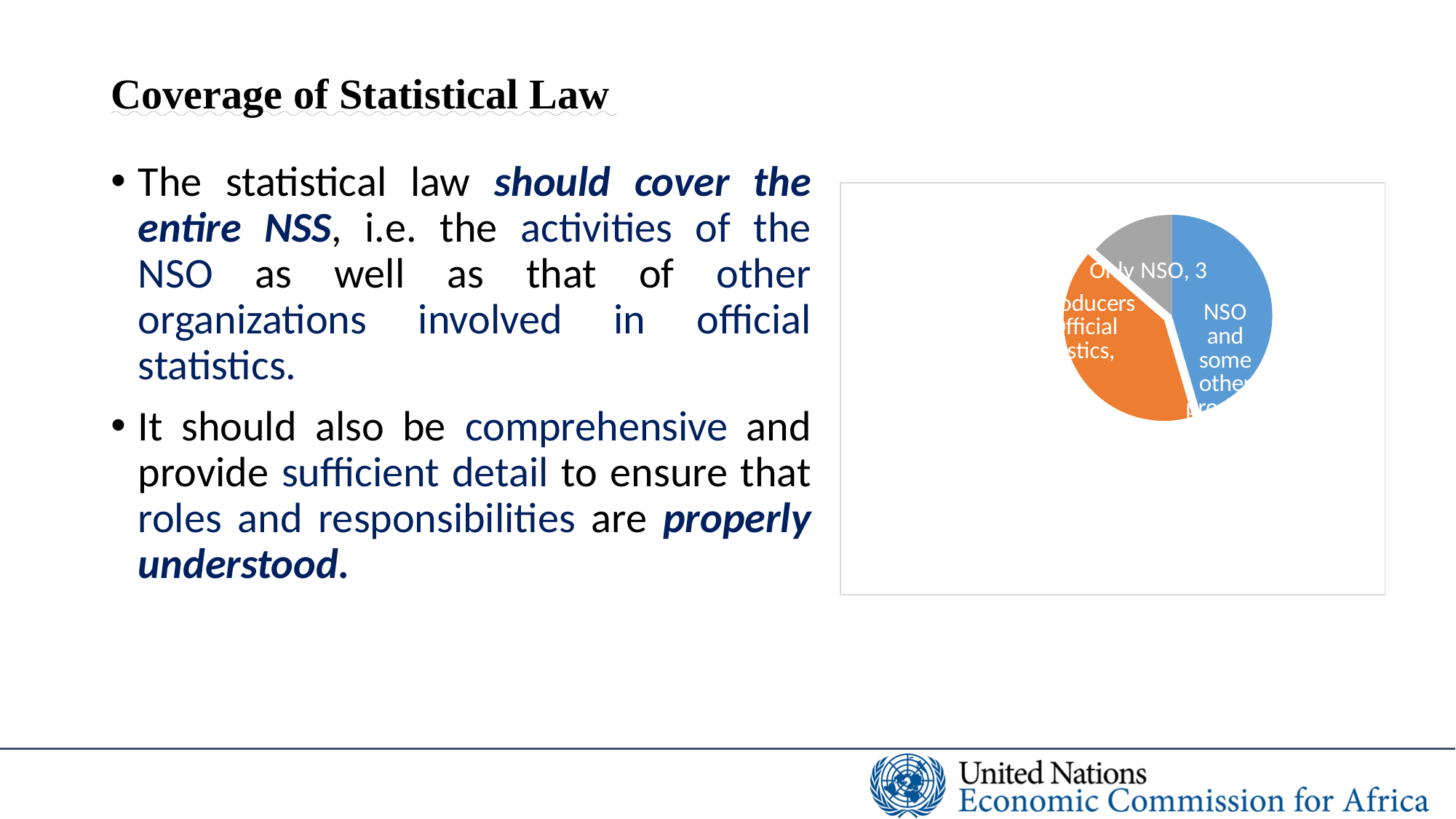
Which slice of the pie chart is the smallest? Only NSO What kind of chart is shown on the slide? pie chart Does the pie chart have a legend? No What value is shown for the "Only NSO" slice of the pie chart? 3 What colour is the "Only NSO" slice in the pie chart? gray How many slices does the pie chart have? 3 Is the "Only NSO" slice larger or smaller than the blue slice of the pie chart? smaller